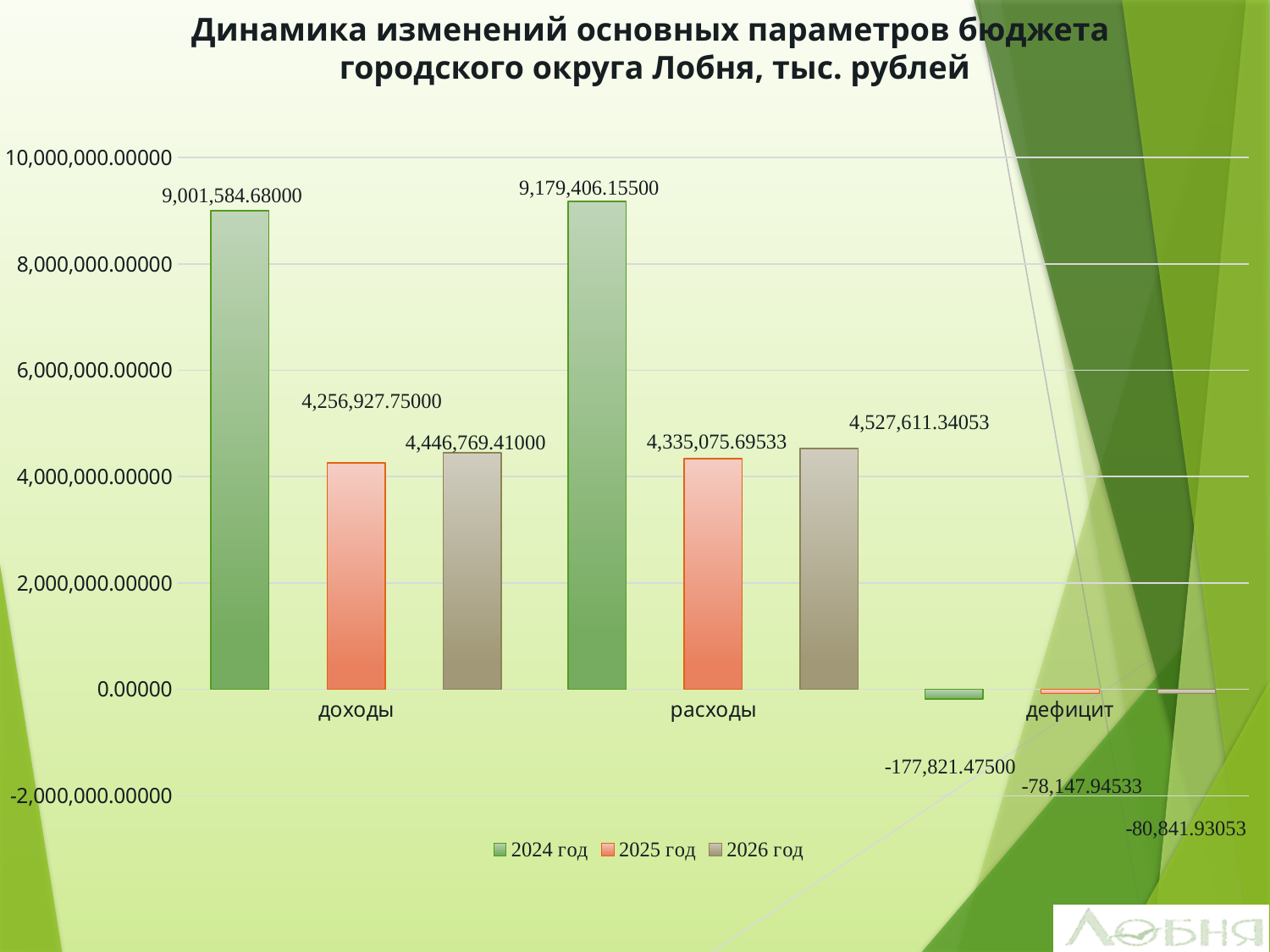
Which is larger for доходы: the 2025 год value or the 2026 год value? 2026 год Which series is shown in orange according to the legend? 2025 год What is the difference between расходы and доходы in the 2024 год series? 177,821.47500 Which category and series has the highest value on the chart? расходы, 2024 год What is the value for расходы in the 2026 год series? 4,527,611.34053 Is the value for доходы in 2024 год greater or less than 8,000,000.00000? greater How many series does the legend list? 3 What kind of chart is shown on the slide? bar chart What is the value for дефицит in the 2025 год series? -78,147.94533 What is the value for доходы in the 2024 год series? 9,001,584.68000 Which category and series has the lowest value on the chart? дефицит, 2024 год How many categories are shown on the x axis? 3